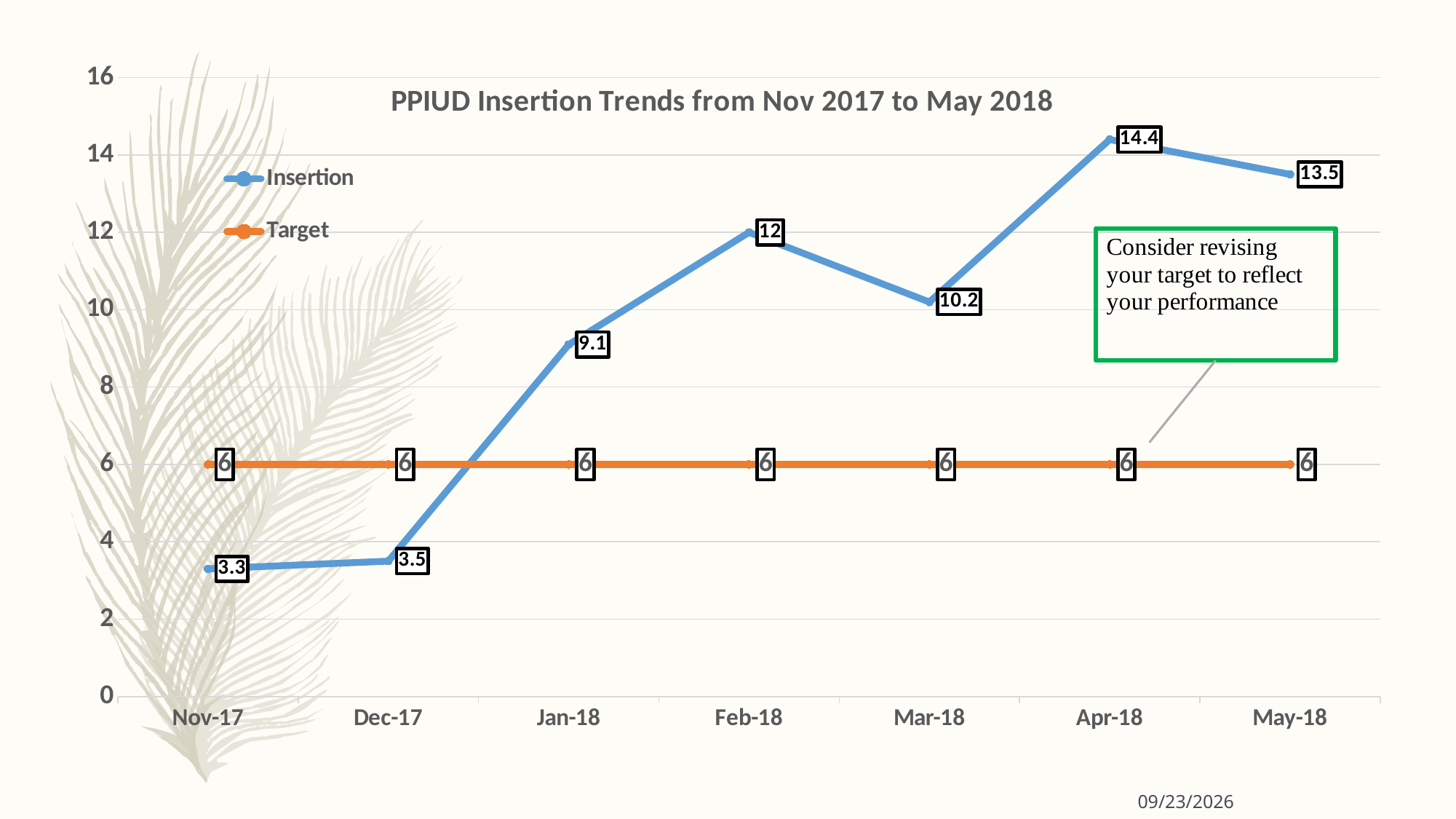
Which month has the highest Insertion value? Apr-18 What kind of chart is shown on the slide? Line chart Which is larger, the Insertion value for Feb-18 or for Mar-18? Feb-18 What is the title of the chart? PPIUD Insertion Trends from Nov 2017 to May 2018 How many months are plotted on the x axis? 7 What is the Target value for Feb-18? 6 How many series does the legend list? 2 What is the Insertion value for Apr-18? 14.4 What is the Insertion value for Nov-17? 3.3 What is the difference between the Insertion values for Apr-18 and May-18? 0.9 Which month has the lowest Insertion value? Nov-17 What is the difference between the Insertion value and the Target value for Mar-18? 4.2